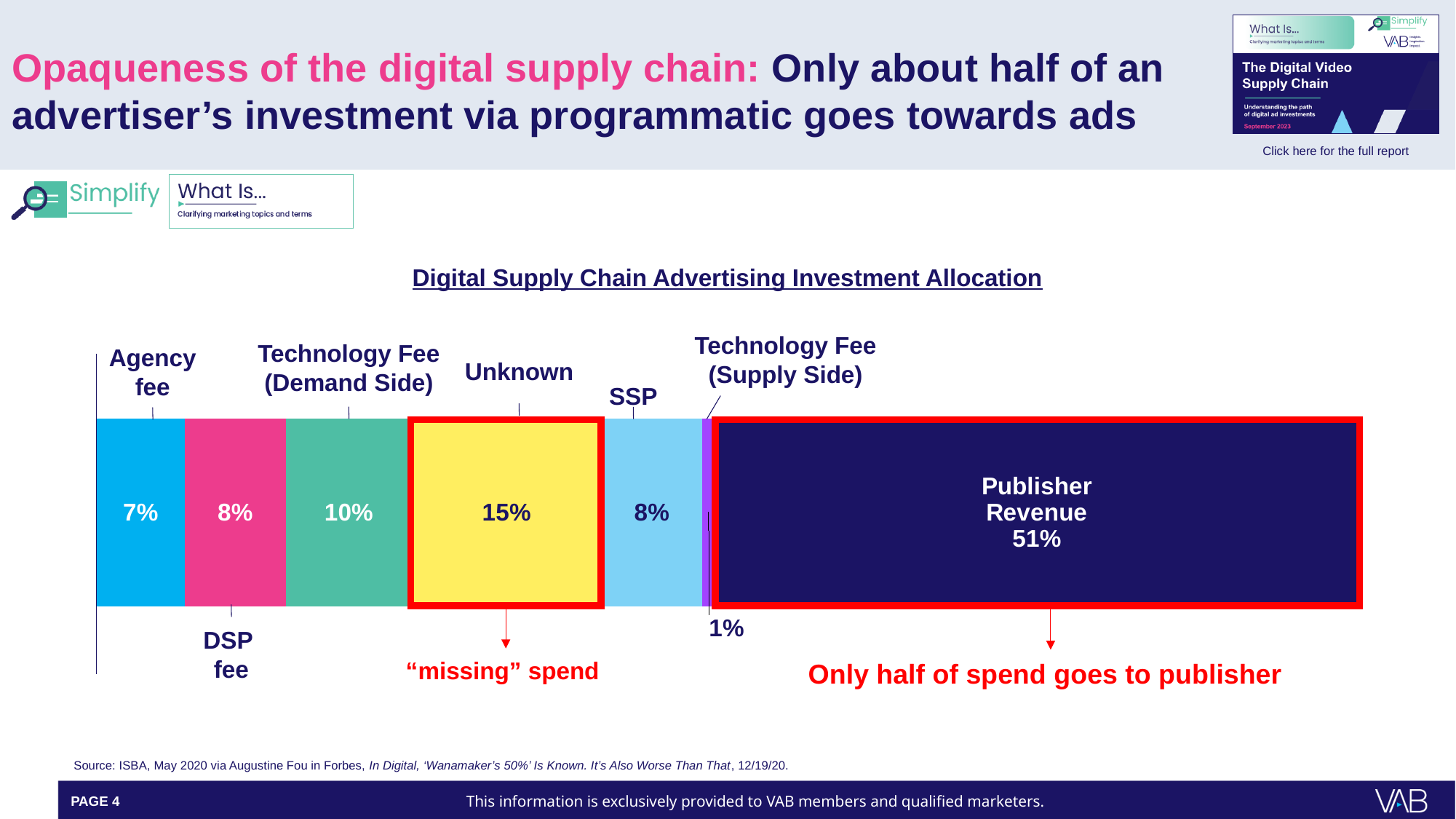
Which is larger, the SSP segment or the Technology Fee (Demand Side) segment? Technology Fee (Demand Side) What is the title of the chart on the slide? Digital Supply Chain Advertising Investment Allocation What share of the advertising investment goes to Publisher Revenue? 51% What is the value for the Technology Fee (Supply Side) segment? 1% What percentage of the investment is labelled Unknown? 15% What is the value for the Agency fee segment? 7% How many segments make up the stacked bar? 7 Which segment of the bar is the smallest? Technology Fee (Supply Side) Which segment of the bar is the largest? Publisher Revenue What type of chart is shown on the slide? Stacked bar chart What is the difference between the Unknown segment and the DSP fee segment? 7% What is the value for the Technology Fee (Demand Side) segment? 10%